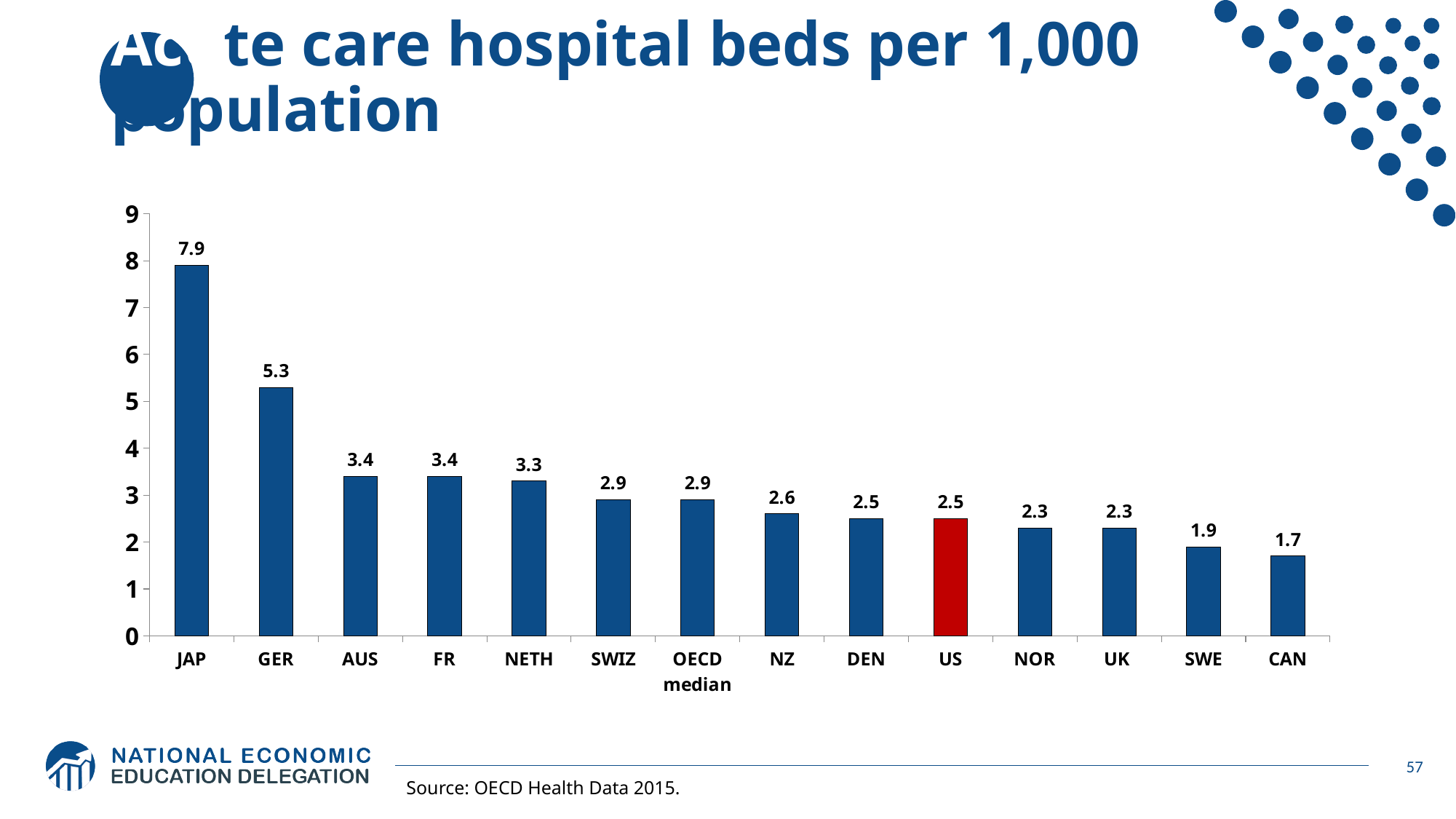
How many bars are shown in the chart? 14 What is the value for JAP? 7.9 What kind of chart is shown on the slide? Bar chart What is the value for the OECD median? 2.9 Which country has the highest number of acute care hospital beds per 1,000 population? JAP What is the difference between the values for JAP and GER? 2.6 What is the value for the US? 2.5 Which country has the lowest number of acute care hospital beds per 1,000 population? CAN What is the difference between the OECD median and the US value? 0.4 Is the value for GER greater or less than 5? greater Which has a larger value, NETH or SWE? NETH Which bar is coloured red instead of blue? US